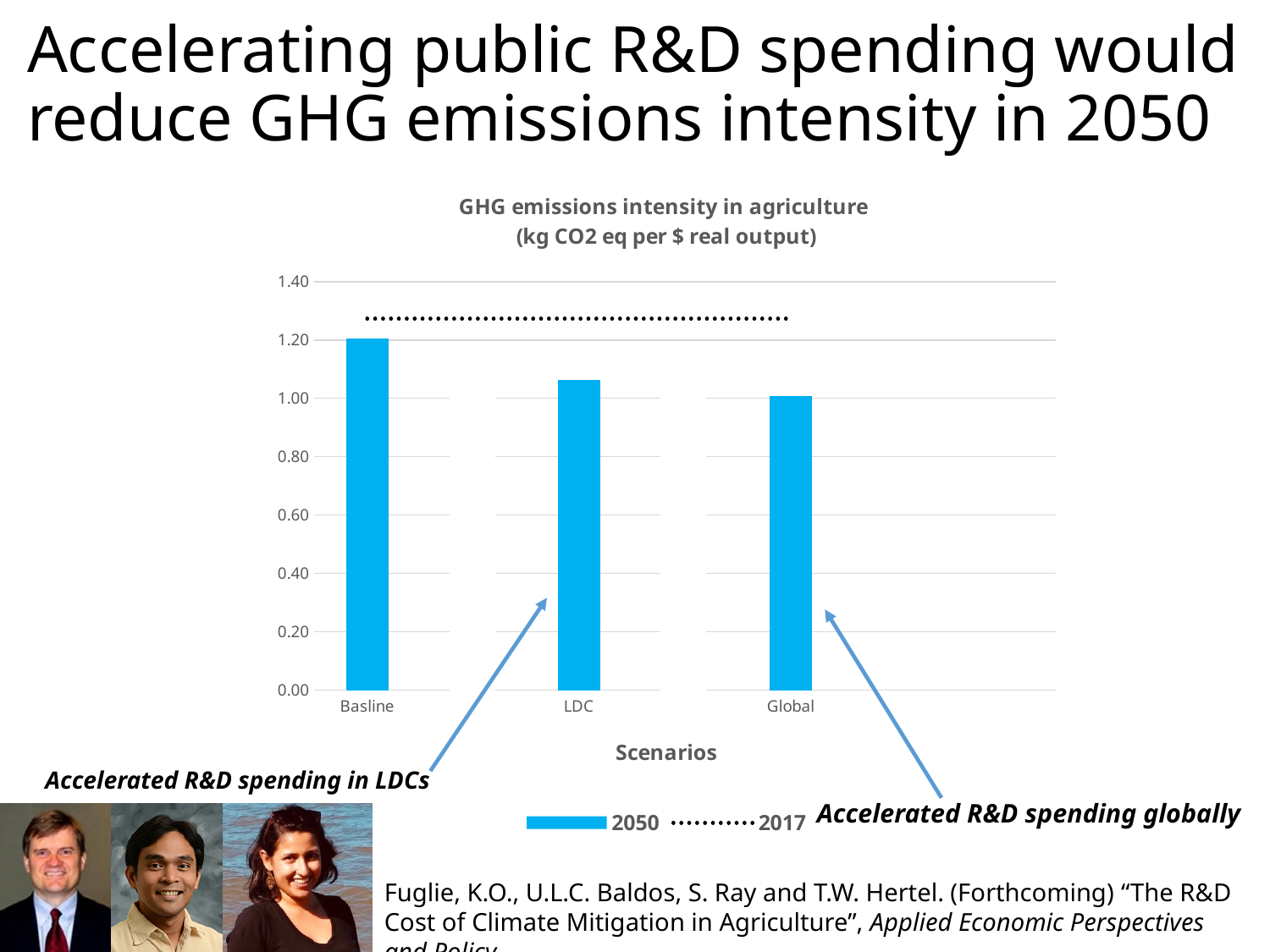
Which scenario has the highest 2050 GHG emissions intensity? Basline How many series does the legend list? 2 Is the 2050 value for Global greater or less than 1.20? less How many scenarios (categories) are plotted on the x axis? 3 Do the 2050 bar values rise or fall from Basline to Global along the x axis? fall Is the 2050 value for Basline greater or less than 1.00? greater Which series is shown as a dotted line in the legend? 2017 What kind of chart is shown on the slide? combination bar and line chart What is the title of the x axis? Scenarios Which has a higher 2050 bar, Basline or LDC? Basline Is the 2050 value for LDC greater or less than 1.20? less Which scenario has the lowest 2050 GHG emissions intensity? Global